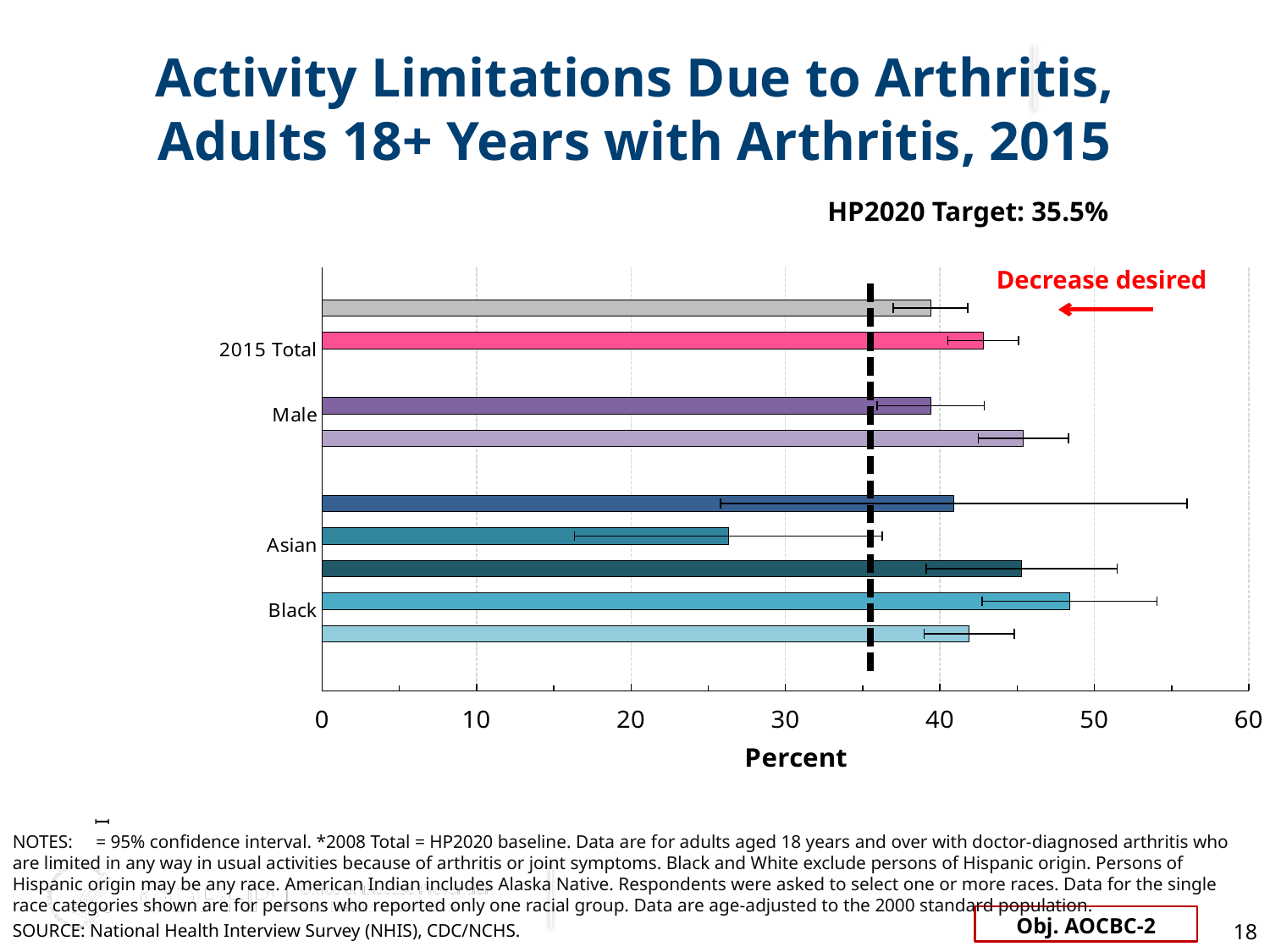
Is the value for Male greater or less than 30? greater Is the value for Black greater or less than 40? greater Which labeled group has the highest value? Black How many bars are plotted in the chart? 9 Which is larger, the value for Male or the value for Black? Black What kind of chart is shown on the slide? bar chart Is the value for Asian greater or less than 30? less What is the title of the x axis? Percent What is the HP2020 Target value shown on the slide? 35.5% Which is larger, the value for Black or the value for Asian? Black Which labeled group has the lowest value? Asian